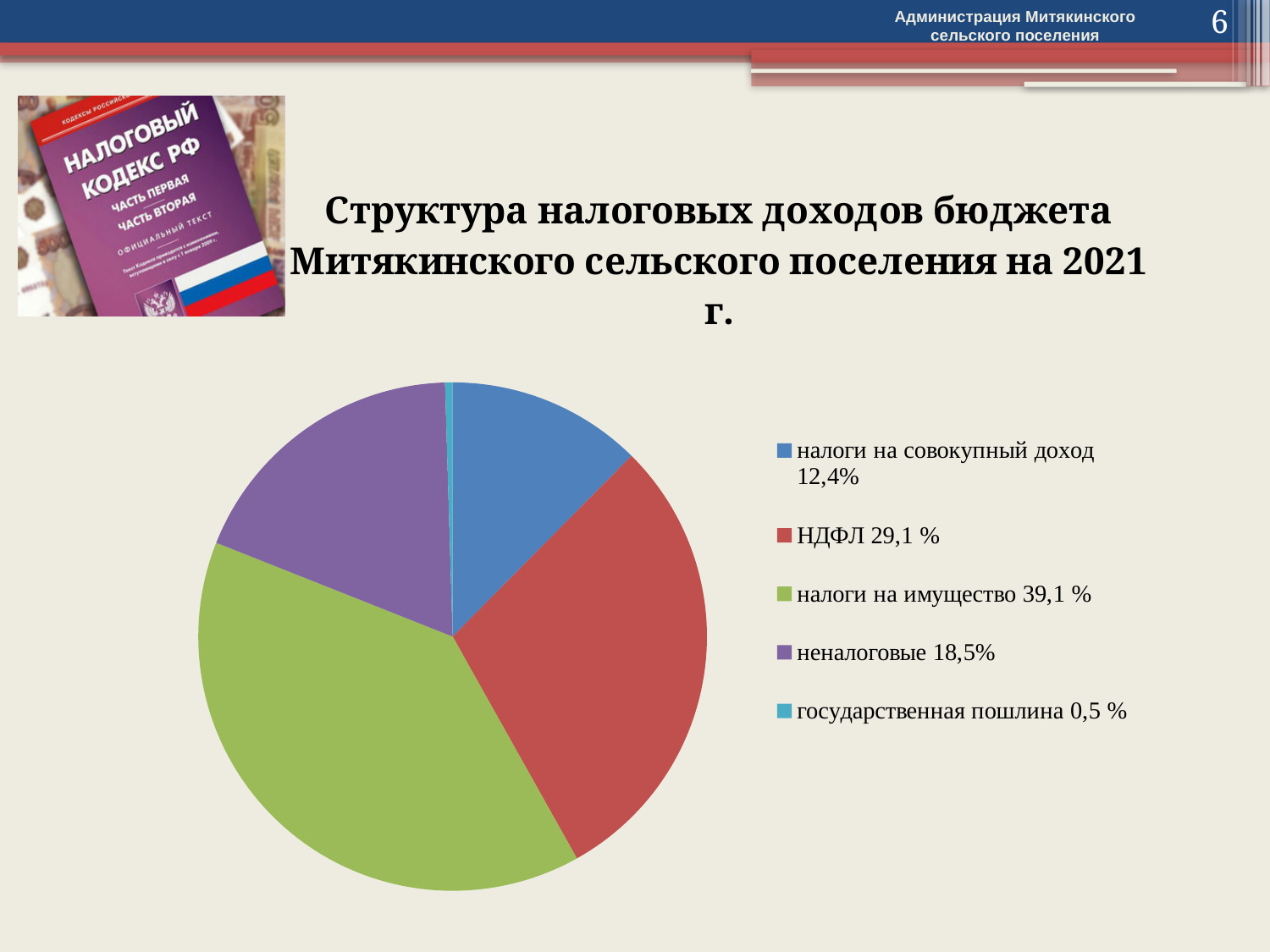
What share of the pie is налоги на имущество? 39,1 % Which category has the largest share of the pie? налоги на имущество What is the difference between the share for налоги на имущество and the share for НДФЛ? 10,0 % What kind of chart is shown on the slide? pie chart What colour is the slice for неналоговые? purple What share of the pie is НДФЛ? 29,1 % Which is larger, the share for НДФЛ or the share for неналоговые? НДФЛ What share of the pie is налоги на совокупный доход? 12,4% What share of the pie is государственная пошлина? 0,5 % What is the difference between the share for неналоговые and the share for налоги на совокупный доход? 6,1 % Which category has the smallest share of the pie? государственная пошлина How many slices does the pie chart have? 5